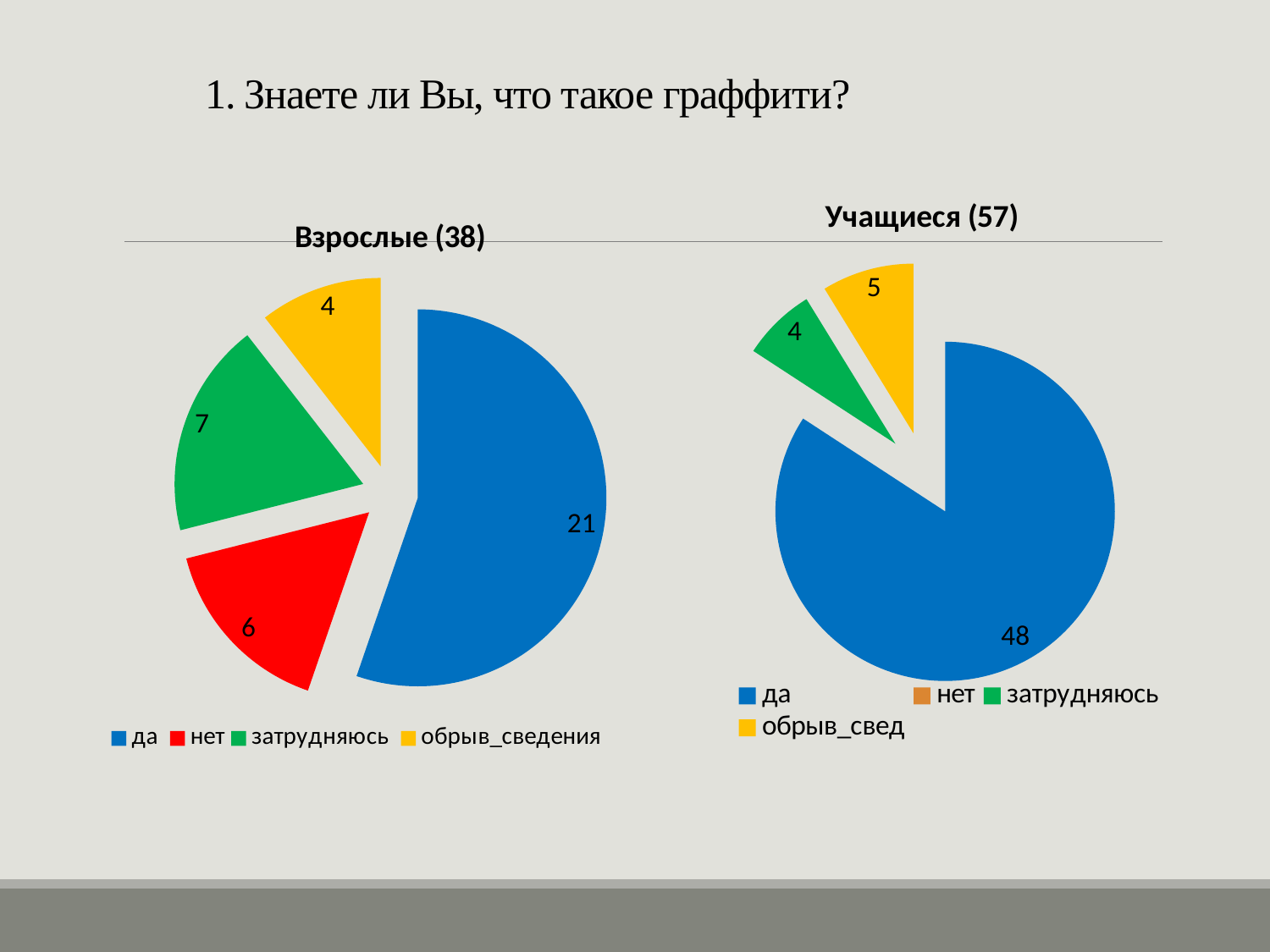
In the 'Учащиеся (57)' chart, what is the difference between the values for 'да' and 'затрудняюсь'? 44 In the 'Учащиеся (57)' chart, what is the value for 'обрыв_свед'? 5 In the 'Взрослые (38)' chart, which category has the smallest slice? обрыв_сведения In the 'Взрослые (38)' chart, which category has the largest slice? да In the 'Взрослые (38)' chart, what is the value for 'да'? 21 In the 'Взрослые (38)' chart, which is larger: 'затрудняюсь' or 'нет'? затрудняюсь In the 'Взрослые (38)' chart, what is the difference between the values for 'да' and 'нет'? 15 In the 'Взрослые (38)' chart, what is the value for 'нет'? 6 In the 'Взрослые (38)' chart, what is the value for 'затрудняюсь'? 7 What type of chart is used on this slide? Pie chart How many entries does the legend of the 'Взрослые (38)' chart list? 4 In the 'Учащиеся (57)' chart, what is the value for 'да'? 48